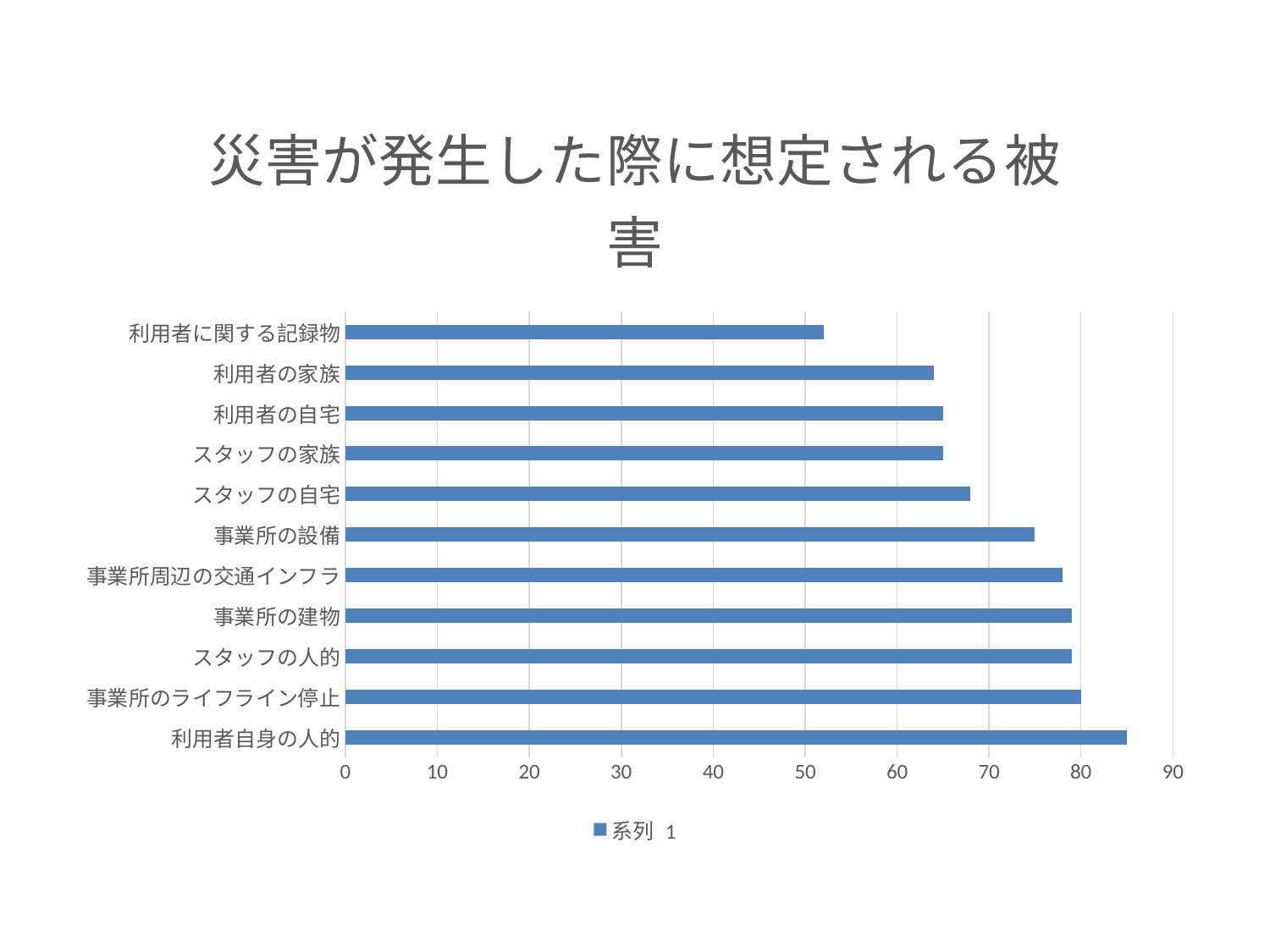
What is the legend entry shown below the chart? 系列 1 Which category has the lowest value? 利用者に関する記録物 How many categories are plotted in the chart? 11 Is the value for 事業所の設備 greater or less than 70? greater Which is larger, the value for 事業所周辺の交通インフラ or the value for スタッフの自宅? 事業所周辺の交通インフラ Is the value for 利用者自身の人的 greater or less than 80? greater What kind of chart is shown on the slide? bar chart Which is larger, the value for 事業所の設備 or the value for 利用者の自宅? 事業所の設備 Is the value for 利用者に関する記録物 greater or less than 60? less What is the title of the chart? 災害が発生した際に想定される被害 How many series does the legend list? 1 Which category has the highest value? 利用者自身の人的